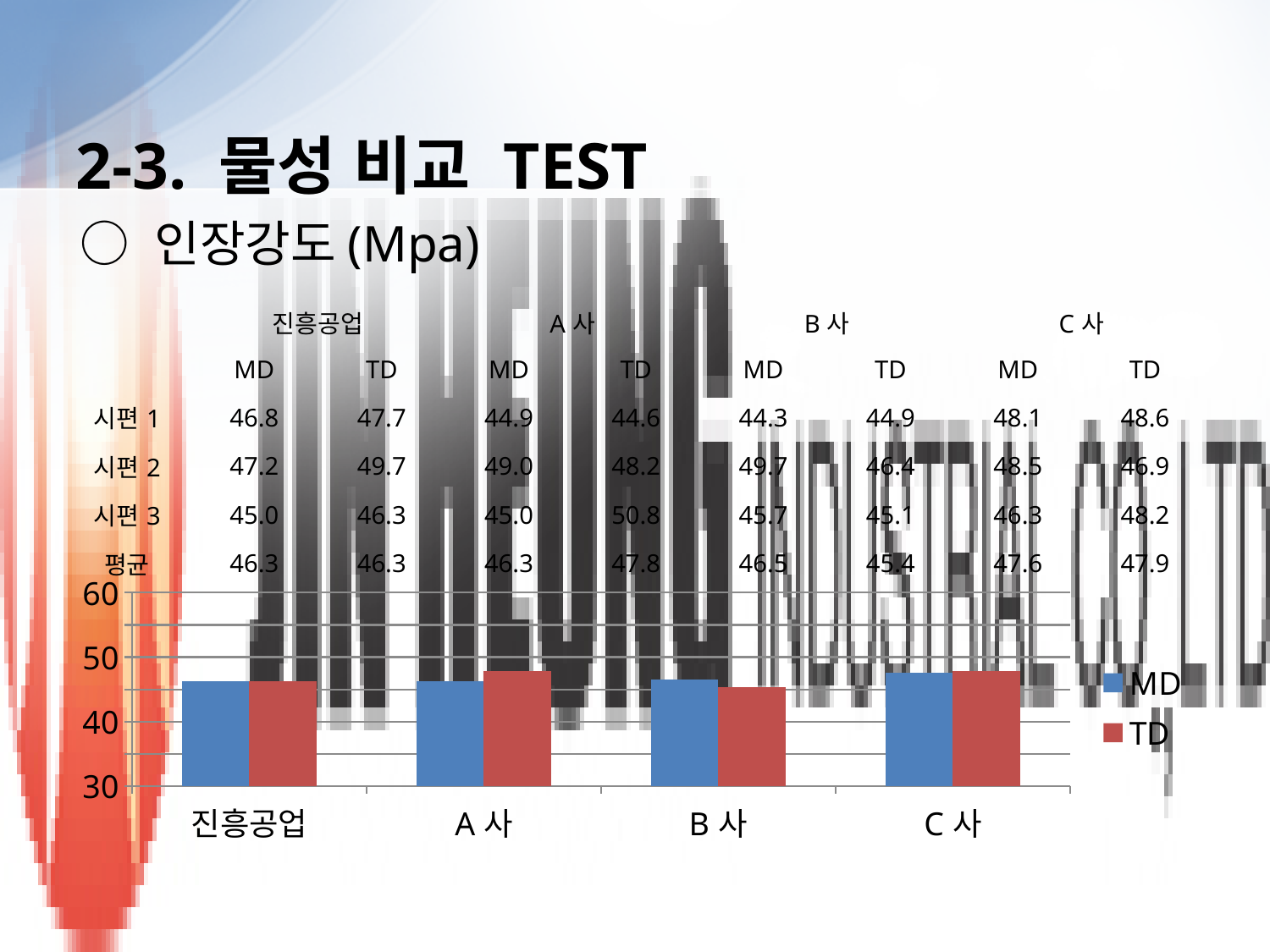
Is the TD value for C 사 greater or less than 50? less Which series is shown in blue in the chart? MD Is the TD value for B 사 greater or less than 40? greater Which is larger, the TD bar for A 사 or the TD bar for B 사? A 사 What kind of chart is shown on the slide? bar chart How many categories are shown on the x axis of the chart? 4 Is the MD value for 진흥공업 greater or less than 50? less Which category has the highest MD bar? C 사 Which category has the lowest TD bar? B 사 How many series does the chart legend list? 2 Which series is shown in red in the chart? TD For B 사, which is larger, the MD bar or the TD bar? MD